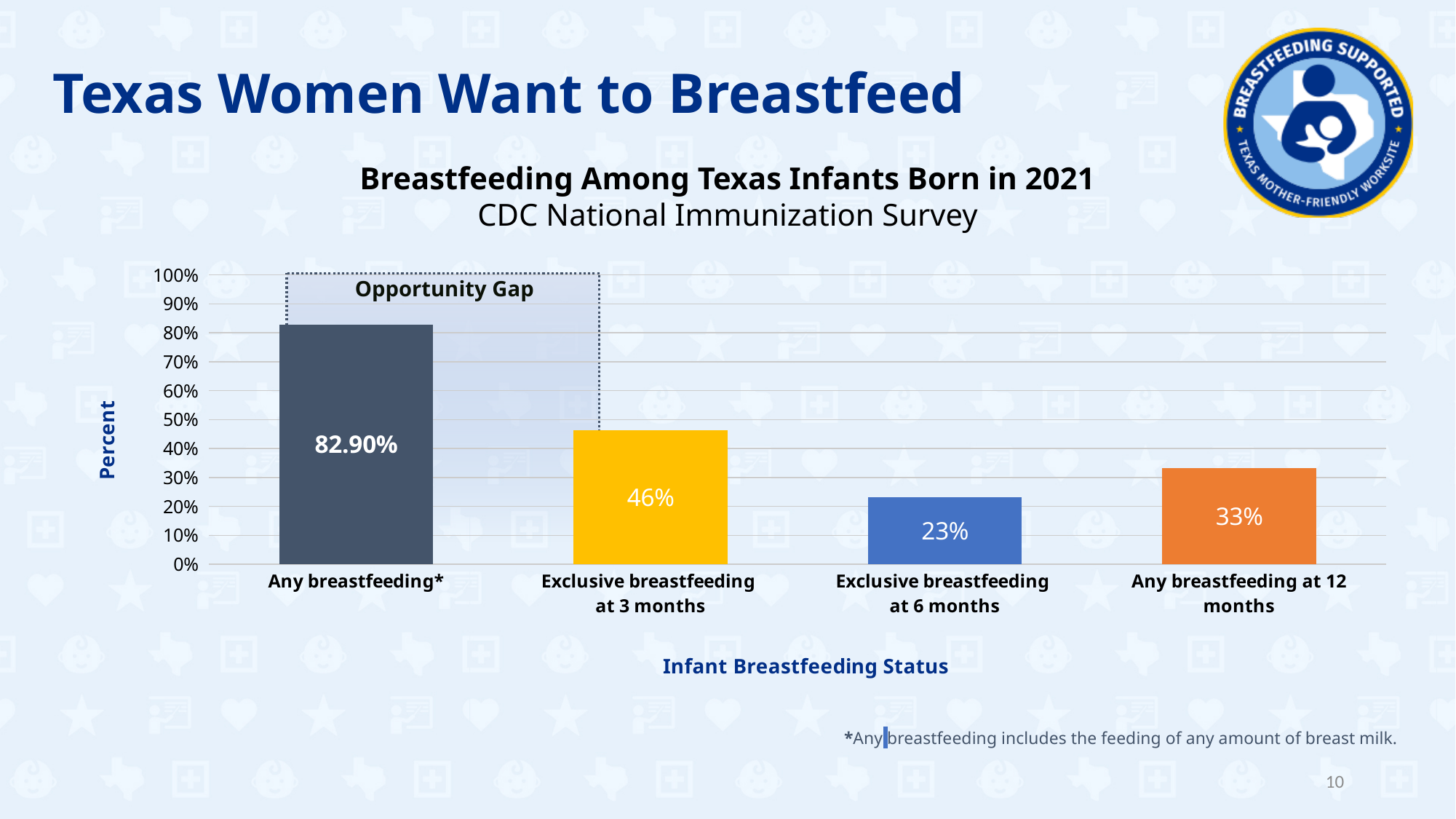
What is the value for Any breastfeeding*? 82.90% Which is larger: Any breastfeeding at 12 months or Exclusive breastfeeding at 6 months? Any breastfeeding at 12 months What is the difference between Exclusive breastfeeding at 3 months and Exclusive breastfeeding at 6 months? 23% What is the label of the y axis? Percent What is the value for Any breastfeeding at 12 months? 33% Which category has the highest value? Any breastfeeding* Is the value for Any breastfeeding* greater or less than 80%? greater What kind of chart is shown on the slide? Bar chart How many categories are shown on the x axis? 4 Which category has the lowest value? Exclusive breastfeeding at 6 months What is the value for Exclusive breastfeeding at 6 months? 23% What is the value for Exclusive breastfeeding at 3 months? 46%